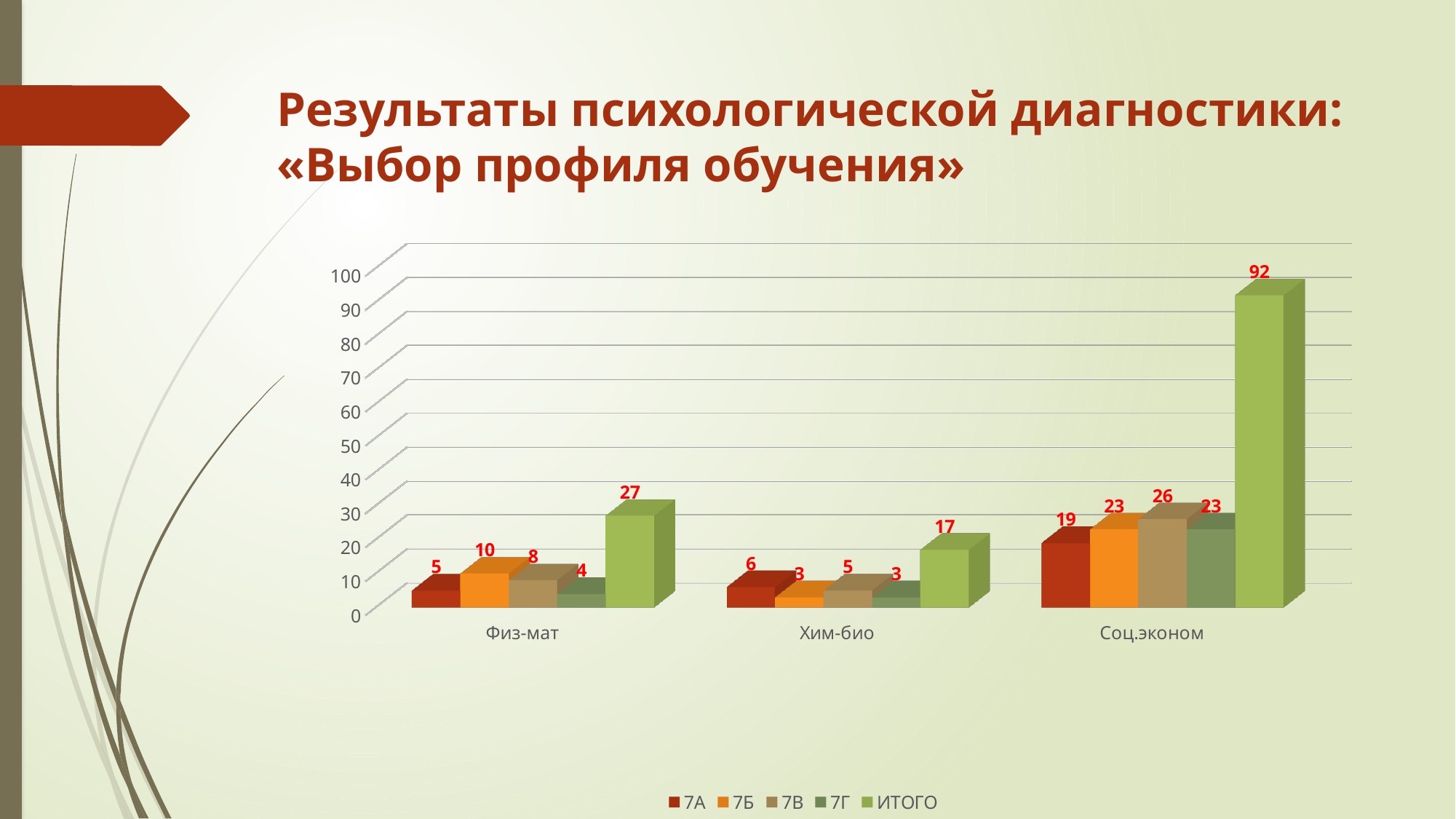
What is the value for 7Б in the Физ-мат category? 10 What is the ИТОГО value for Соц.эконом? 92 How many series does the legend list? 5 Which is larger: the 7А value for Соц.эконом or the 7А value for Физ-мат? Соц.эконом Which category has the highest ИТОГО value? Соц.эконом What is the value for 7В in the Хим-био category? 5 Is the ИТОГО value for Соц.эконом greater or less than 50? greater Which category has the lowest ИТОГО value? Хим-био What is the difference between the ИТОГО values for Соц.эконом and Физ-мат? 65 What kind of chart is shown on the slide? bar chart Which series in the Соц.эконом category has the highest value among the four classes (7А, 7Б, 7В, 7Г)? 7В How many categories are shown on the x axis? 3